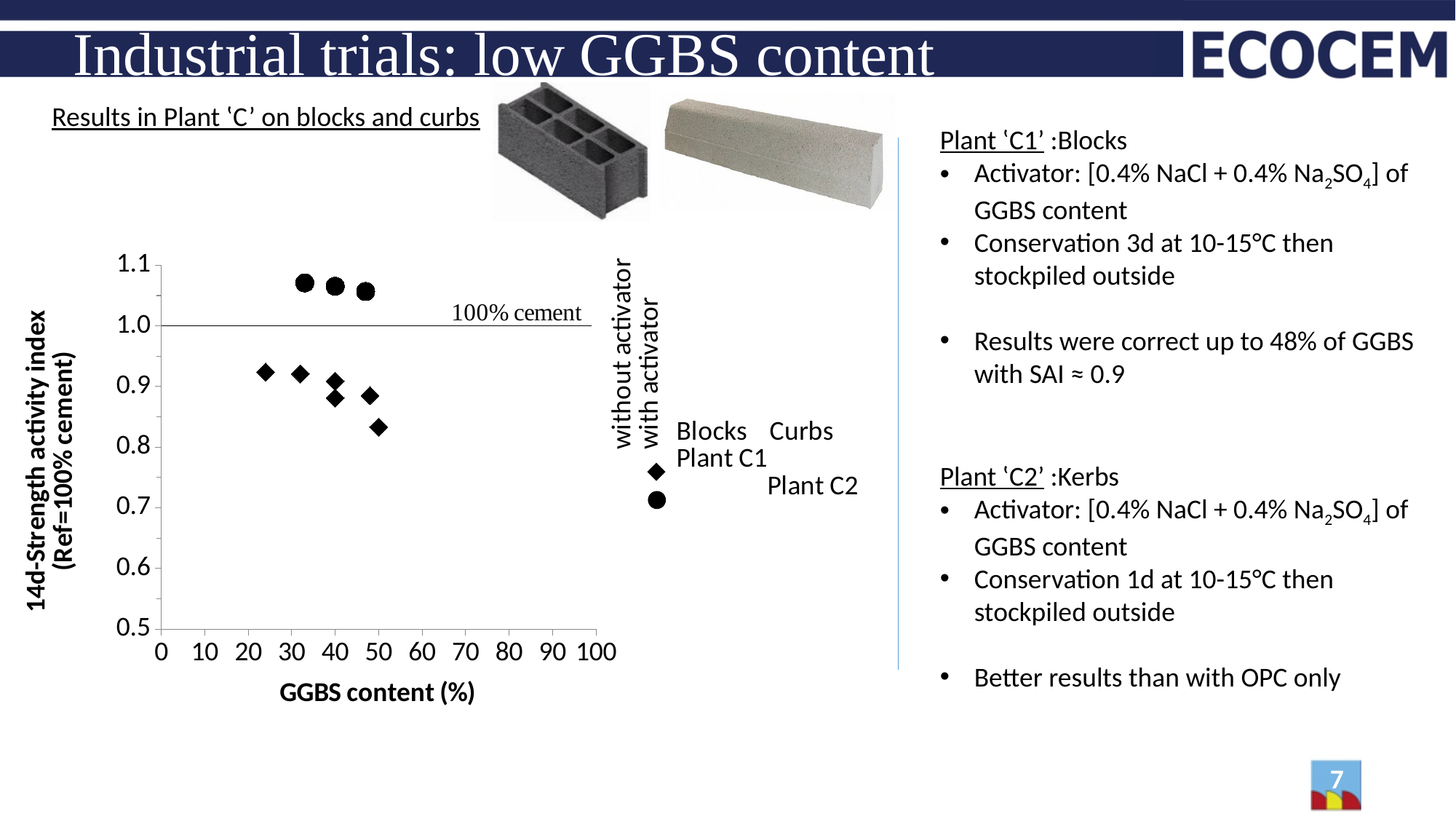
How many series does the chart legend list? 2 Do the Plant C1 (diamond) values rise or fall as GGBS content increases? fall Which series has the higher strength activity index values overall, Plant C1 or Plant C2? Plant C2 How many circle (Plant C2) points are plotted on the chart? 3 What label is written on the horizontal reference line at 1.0? 100% cement Are the Plant C1 (diamond) values greater or less than 1.0? less At a GGBS content of 40%, which series has the higher strength activity index, Plant C1 or Plant C2? Plant C2 Are the Plant C2 (circle) values greater or less than 1.0? greater Is the lowest Plant C1 (diamond) value greater or less than 0.9? less How many diamond (Plant C1) points are plotted on the chart? 6 What is the title of the x axis of the chart? GGBS content (%) What kind of chart is shown on the slide? scatter chart